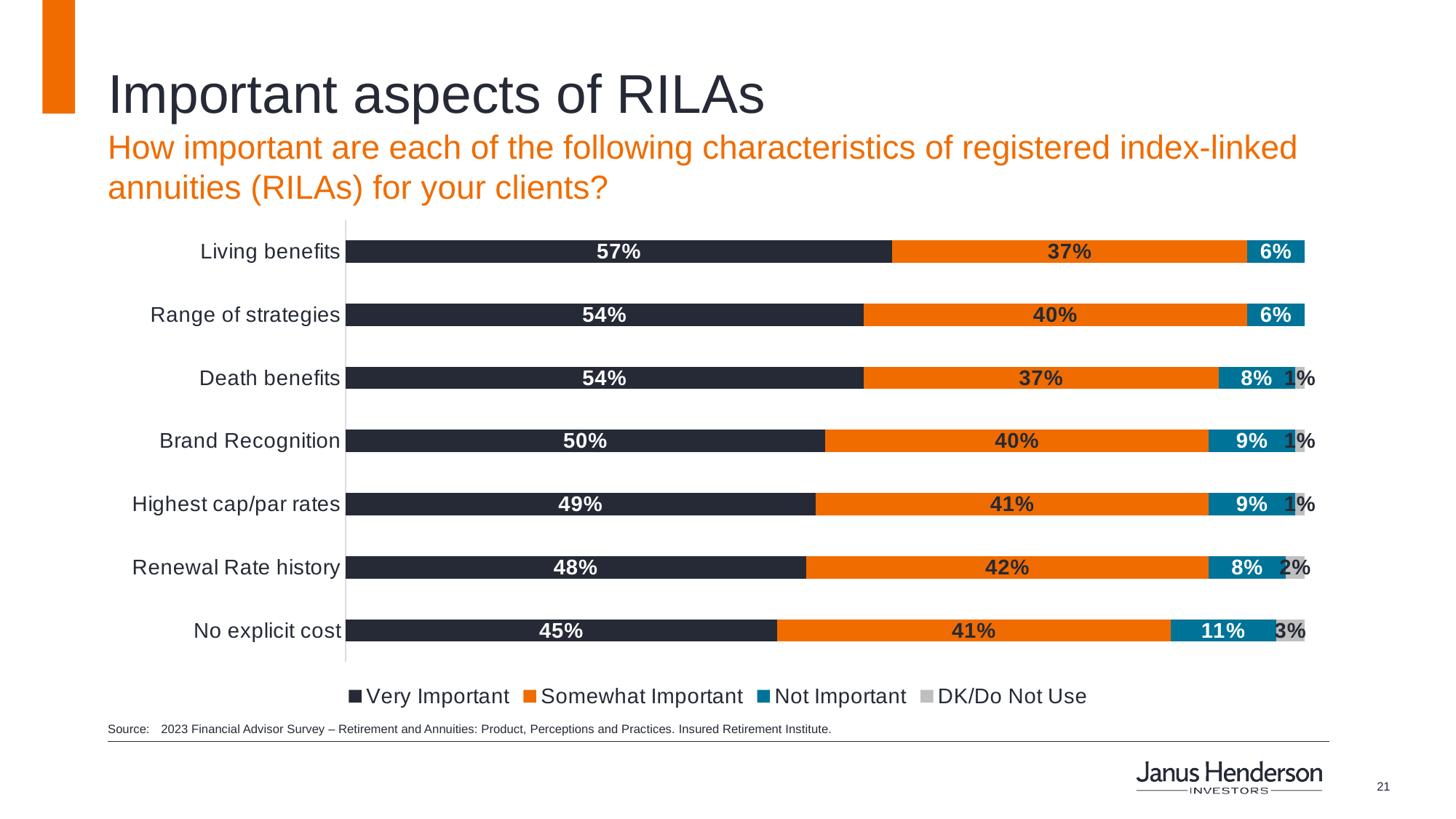
How many characteristics are listed on the chart? 7 What percentage of advisors rated Living benefits as Very Important? 57% Which characteristic has the highest Very Important percentage? Living benefits What is the difference between the Very Important values for Living benefits and No explicit cost? 12% Which legend entry is shown in orange? Somewhat Important Which is larger: the Somewhat Important value for Range of strategies or for Death benefits? Range of strategies Which characteristic has the lowest Very Important percentage? No explicit cost What is the Somewhat Important value for Renewal Rate history? 42% What kind of chart is shown on the slide? Stacked bar chart What is the combined Very Important and Somewhat Important percentage for Brand Recognition? 90% What is the Not Important value for No explicit cost? 11% How many series does the legend list? 4